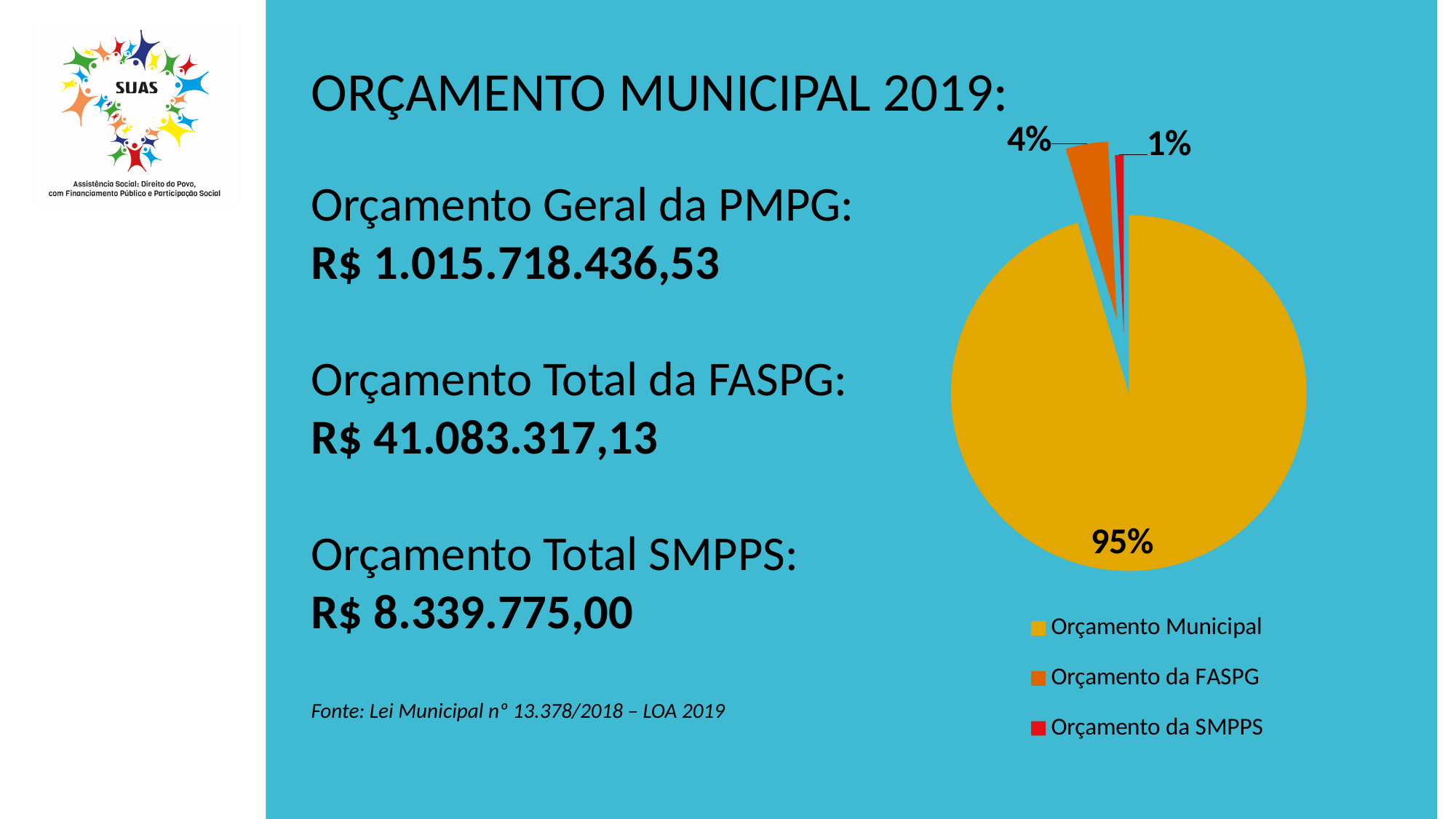
Which slice of the pie is the largest? Orçamento Municipal What is the difference in percentage points between the Orçamento Municipal slice and the Orçamento da FASPG slice? 91 How many slices does the pie chart have? 3 What colour is the Orçamento Municipal slice in the pie chart? yellow What percentage of the pie does Orçamento Municipal represent? 95% What colour is the Orçamento da FASPG slice in the pie chart? orange How many entries does the legend list? 3 Which slice of the pie is the smallest? Orçamento da SMPPS What percentage of the pie does Orçamento da FASPG represent? 4% What kind of chart is shown on the slide? pie chart What percentage of the pie does Orçamento da SMPPS represent? 1% Which is larger, the share for Orçamento da FASPG or the share for Orçamento da SMPPS? Orçamento da FASPG